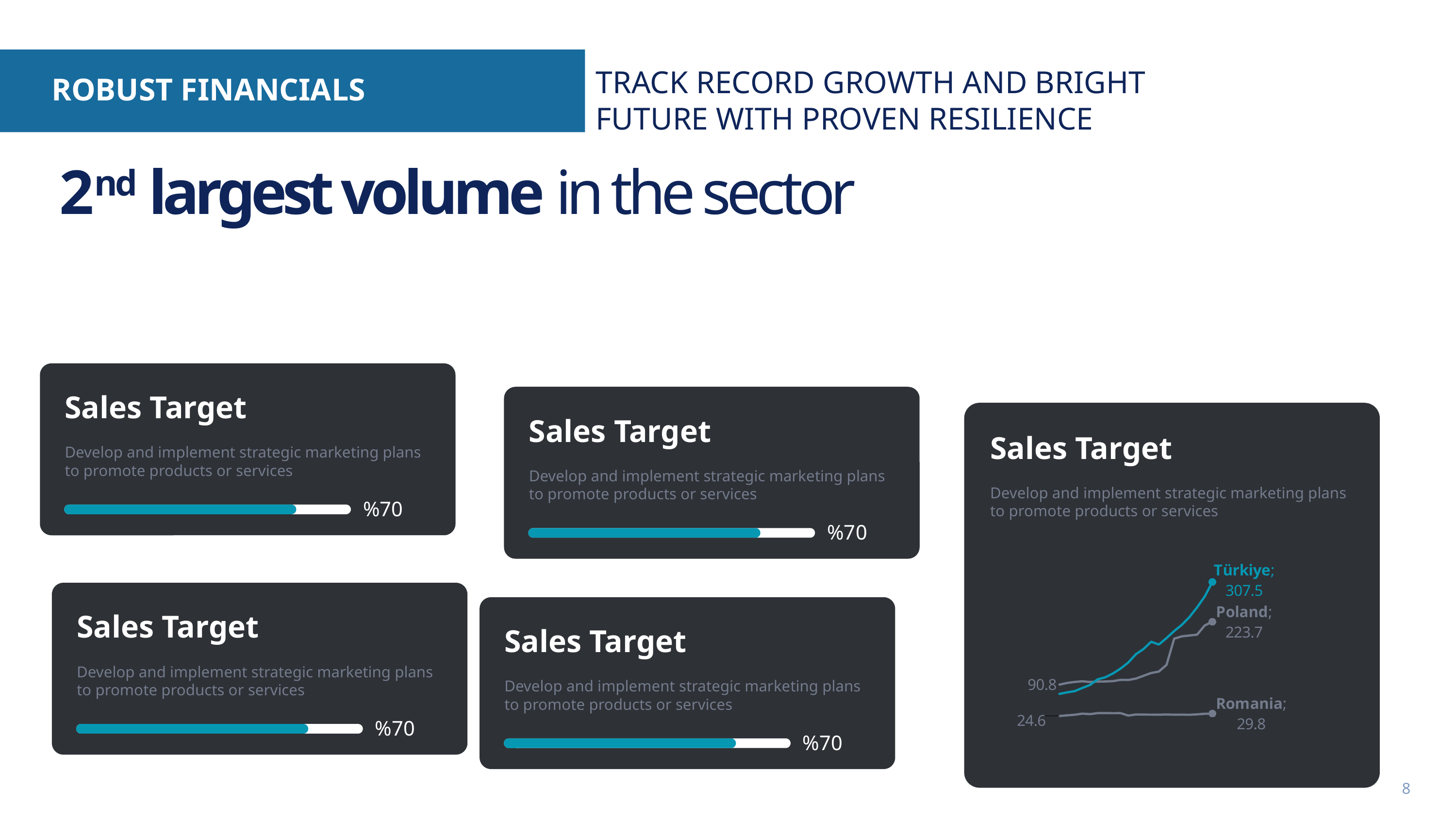
In the line chart on the right, what is the final value labelled for Türkiye? 307.5 What kind of chart is shown in the rightmost Sales Target card? line chart In the line chart on the right, what is the difference between the final values of Türkiye and Poland? 83.8 In the line chart on the right, what is the starting value labelled for the Romania line? 24.6 In the line chart on the right, which country has the lowest final value? Romania In the line chart on the right, what is the final value labelled for Romania? 29.8 In the line chart on the right, what is the difference between the final values of Poland and Romania? 193.9 In the line chart on the right, which has a larger final value, Poland or Romania? Poland In the line chart on the right, which country has the highest final value? Türkiye In the line chart on the right, what is the final value labelled for Poland? 223.7 How many country lines are plotted in the line chart on the right? 3 In the line chart on the right, does the Türkiye line rise or fall from left to right? rise